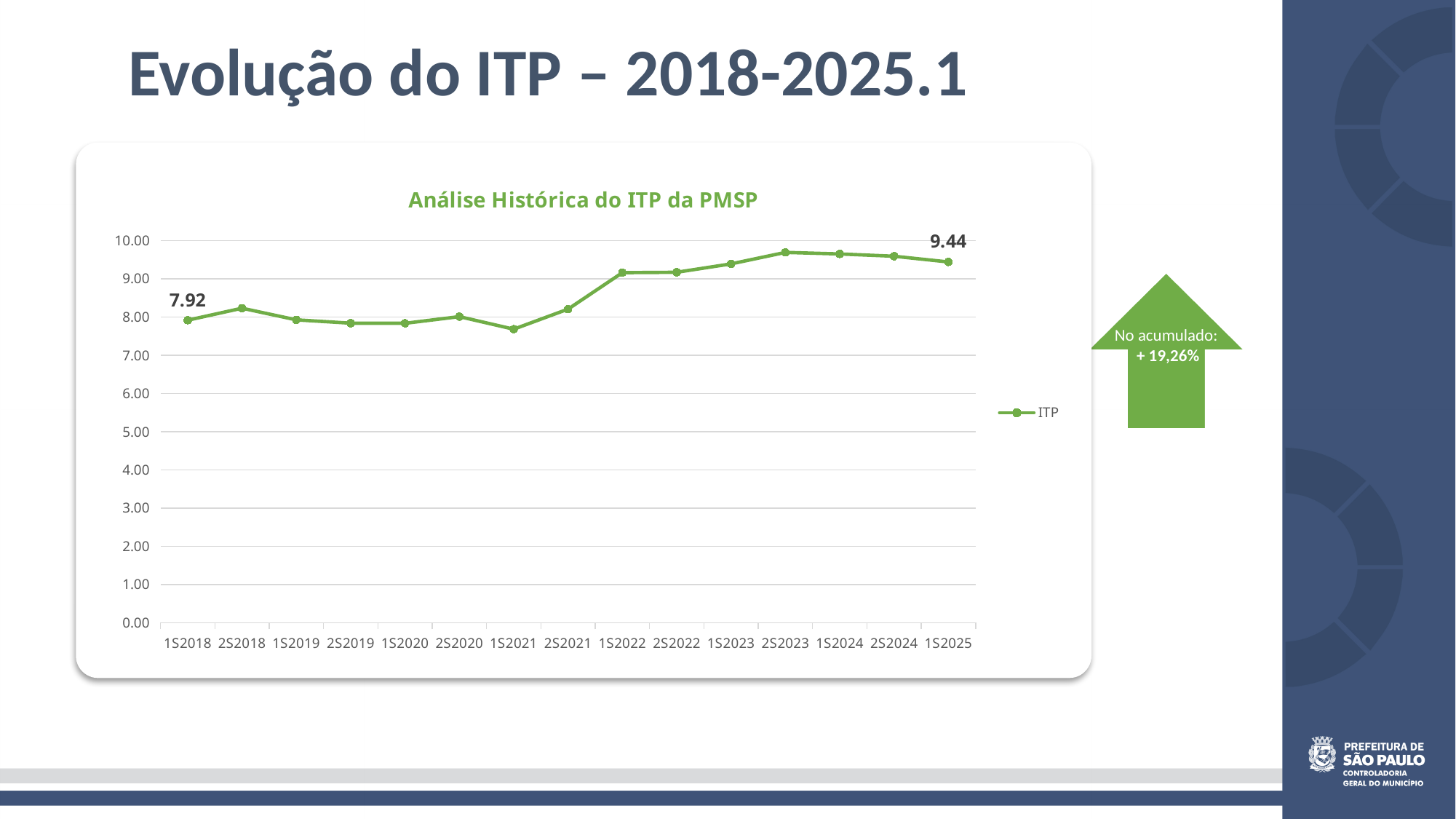
Which period has the lowest ITP value? 1S2021 What kind of chart is shown on the slide? Line chart What is the title of the chart? Análise Histórica do ITP da PMSP What is the ITP value for 1S2025? 9.44 What is the difference between the ITP value for 1S2025 and the value for 1S2018? 1.52 How many series does the legend list? 1 Is the ITP value for 2S2023 greater or less than 9.00? greater What is the ITP value for 1S2018? 7.92 Overall, does the ITP value rise or fall from 1S2018 to 1S2025? Rise How many periods are plotted on the x axis of the chart? 15 Which period has the larger ITP value, 1S2018 or 1S2025? 1S2025 Is the ITP value for 1S2021 greater or less than 8.00? less